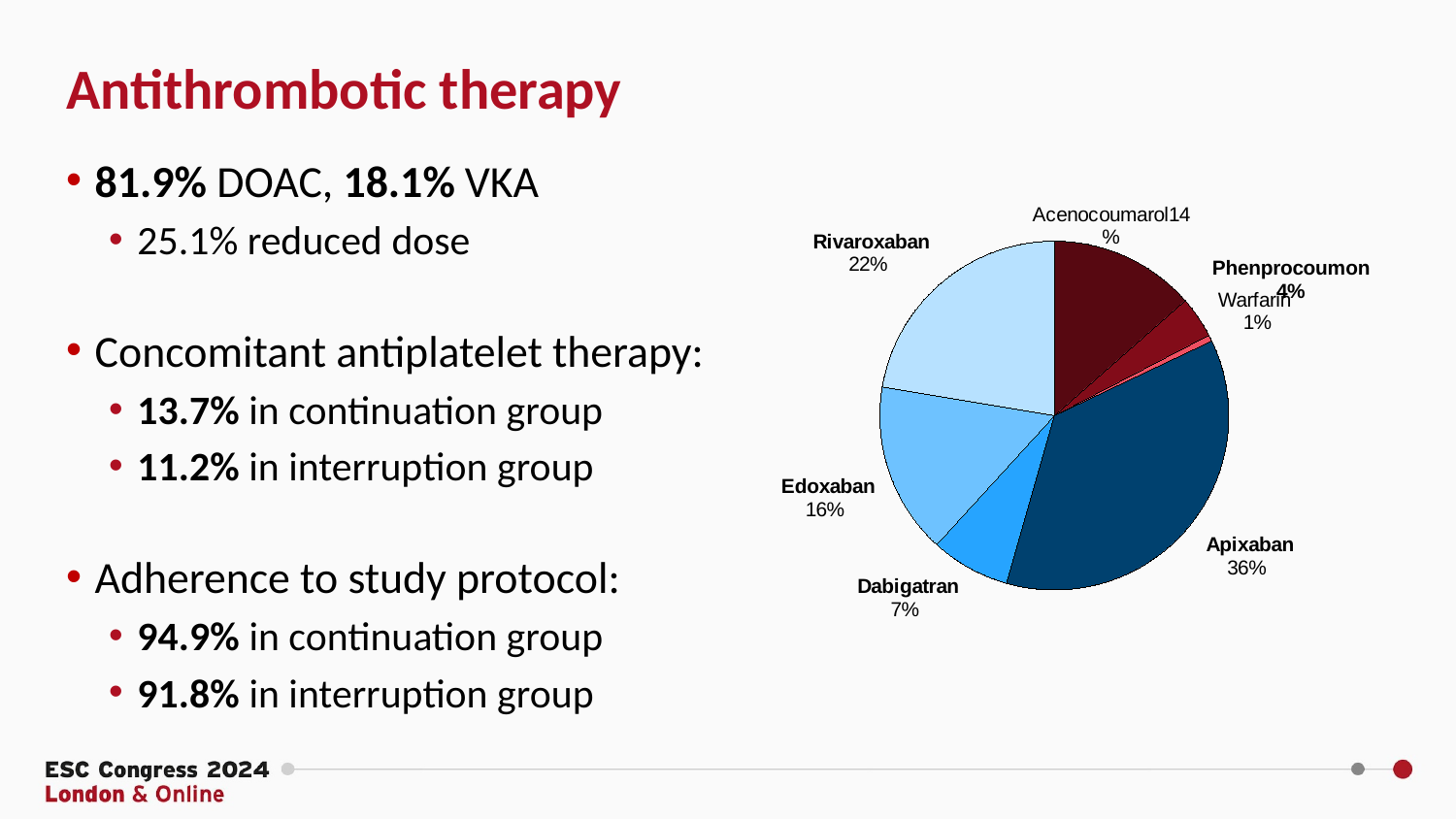
What percentage is shown for Warfarin in the pie chart? 1% Which has a larger share in the pie chart, Edoxaban or Acenocoumarol? Edoxaban What percentage is shown for Dabigatran in the pie chart? 7% What kind of chart is shown on the slide? pie chart What share of the pie chart does Apixaban account for? 36% What percentage is shown for Acenocoumarol in the pie chart? 14% Which drug has the largest slice in the pie chart? Apixaban How many slices does the pie chart have? 7 What percentage is shown for Rivaroxaban in the pie chart? 22% What percentage is shown for Edoxaban in the pie chart? 16% What is the difference in percentage points between Apixaban and Rivaroxaban in the pie chart? 14 Which drug has the smallest slice in the pie chart? Warfarin